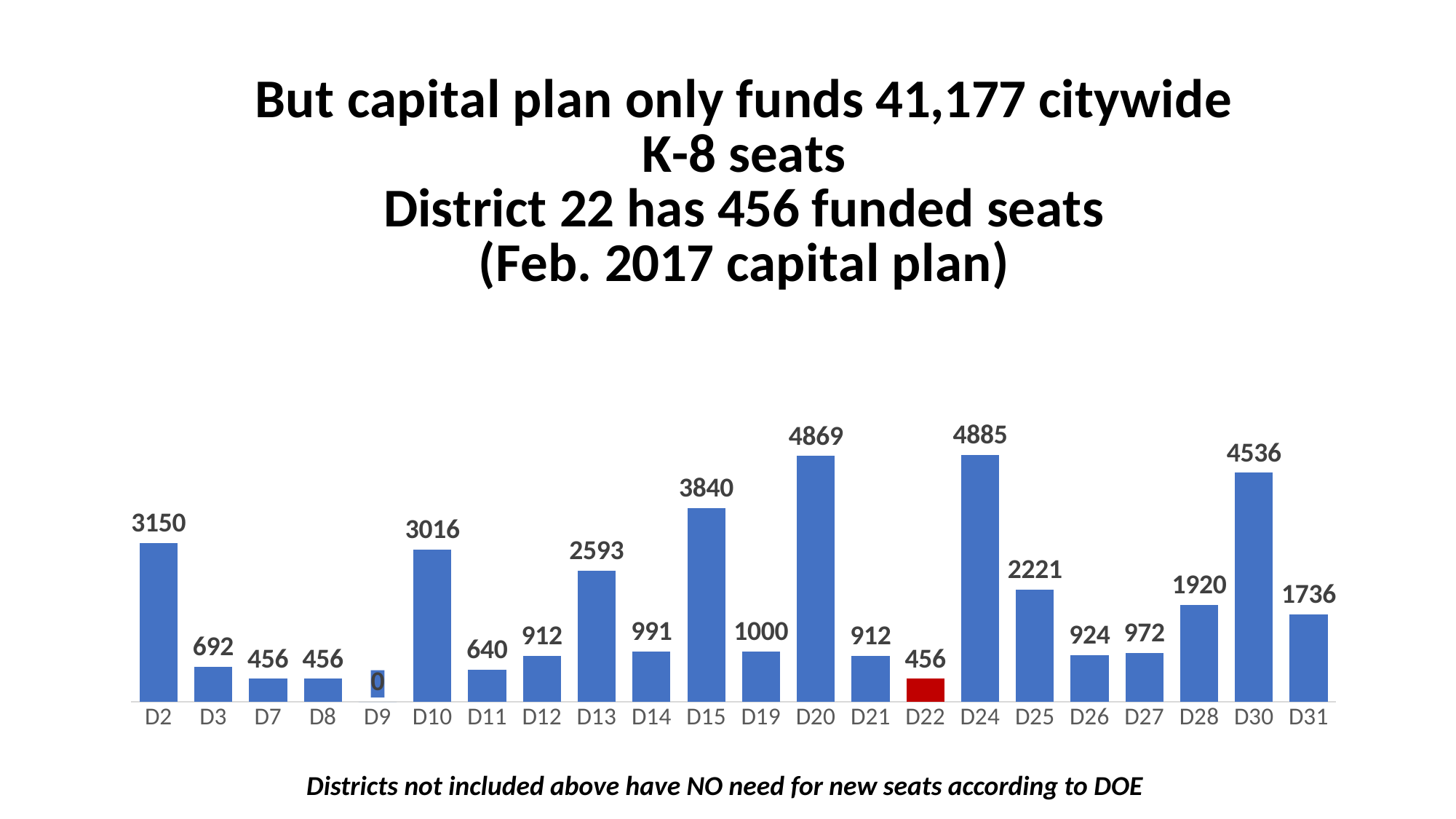
What is the value for D15? 3840 What is the difference between the values for D20 and D15? 1029 Which is larger, the value for D13 or the value for D25? D13 How many districts are shown on the x axis? 22 Which district has the lowest value? D9 What is the value for D22? 456 Which district's bar is coloured red? D22 What kind of chart is shown? Bar chart What is the value for D9? 0 What is the difference between the values for D30 and D28? 2616 What is the value for D30? 4536 Which district has the highest value? D24